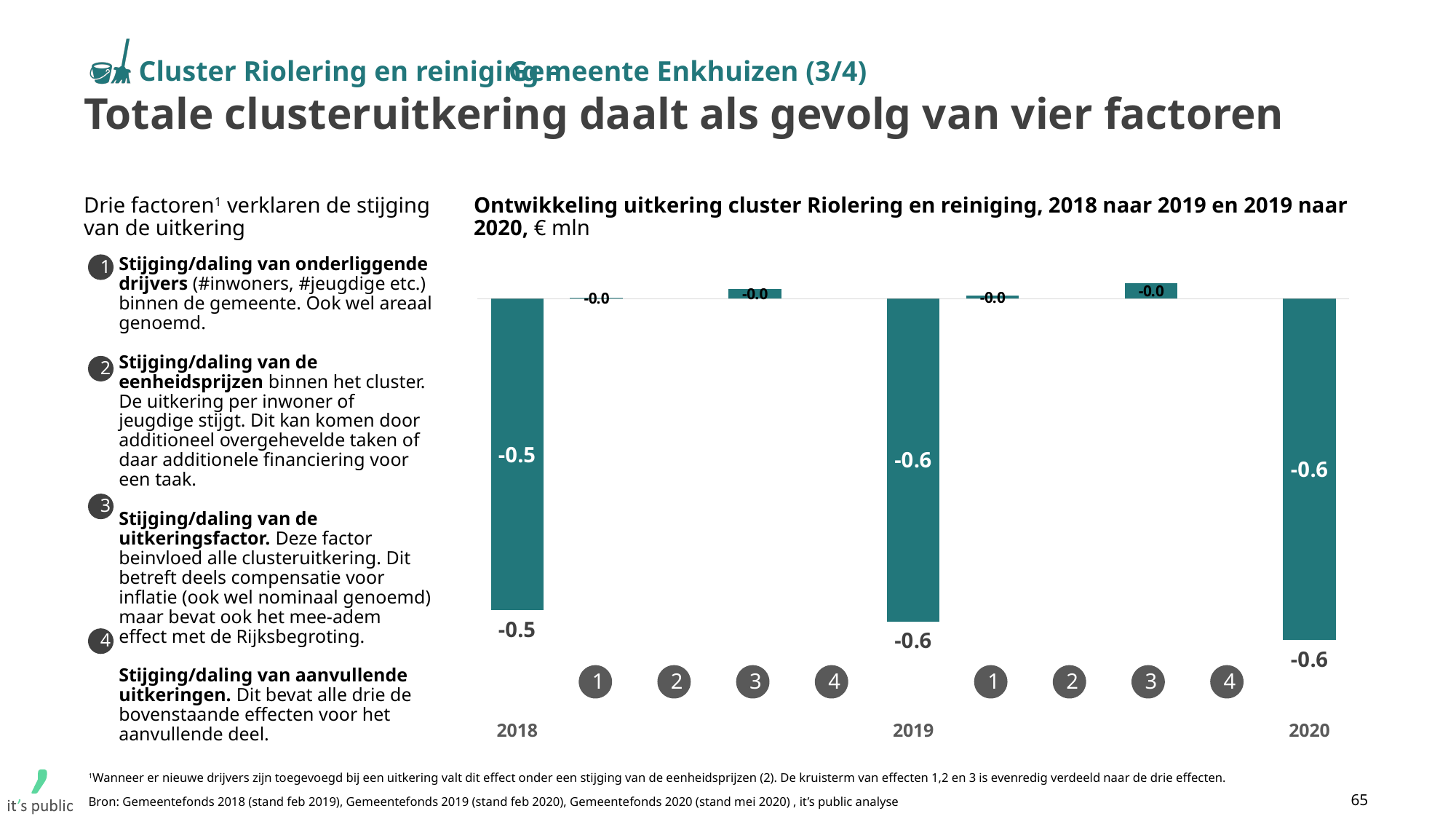
What value is labelled on the factor 1 bar between 2018 and 2019? -0.0 In what unit are the values in the chart expressed? € mln What is the difference between the 2018 value and the 2019 value? 0.1 What is the value shown for 2019 in the chart? -0.6 Does the year total value rise or fall from 2018 to 2020? Fall How many year totals (2018, 2019, 2020) are shown in the chart? 3 What kind of chart is shown on the slide? Bar chart Which year has the higher value, 2018 or 2019? 2018 What value is labelled on the factor 3 bar between 2019 and 2020? -0.0 How many numbered factor bars are shown between 2018 and 2019? 4 What is the value shown for 2020 in the chart? -0.6 What is the value shown for 2018 in the chart? -0.5